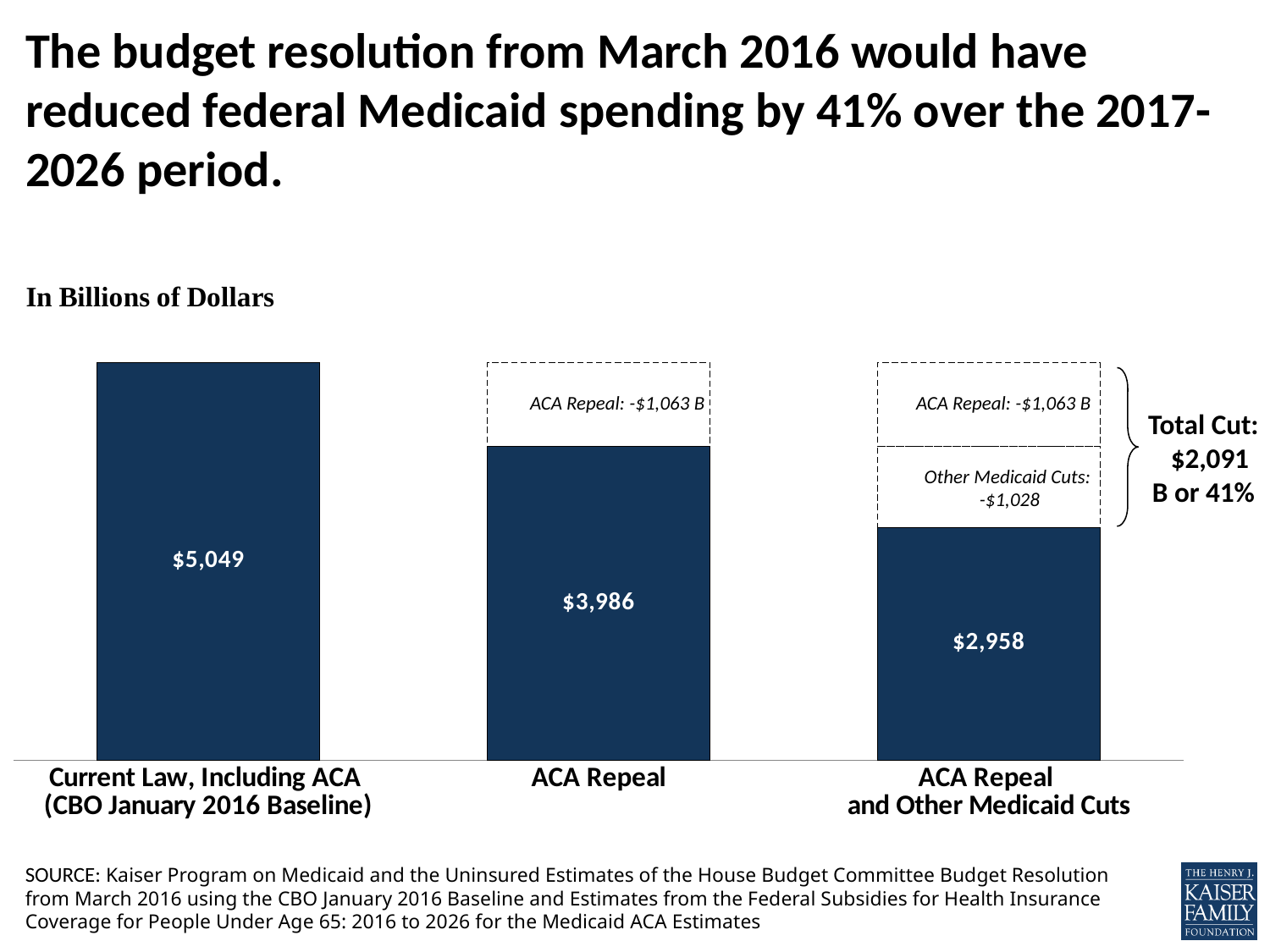
Which category has the lowest value? ACA Repeal and Other Medicaid Cuts Do the bar values rise or fall from left to right along the x axis? Fall Which category has the highest value? Current Law, Including ACA (CBO January 2016 Baseline) What is the difference between the ACA Repeal value and the ACA Repeal and Other Medicaid Cuts value? $1,028 Which is larger, the value for ACA Repeal or the value for ACA Repeal and Other Medicaid Cuts? ACA Repeal What kind of chart is shown on the slide? Bar chart What is the value for ACA Repeal and Other Medicaid Cuts? $2,958 What total cut is labelled beside the ACA Repeal and Other Medicaid Cuts bar? $2,091 B or 41% What is the value for ACA Repeal? $3,986 How many categories are shown on the x axis? 3 What is the value for Current Law, Including ACA (CBO January 2016 Baseline)? $5,049 What is the difference between the Current Law, Including ACA value and the ACA Repeal value? $1,063